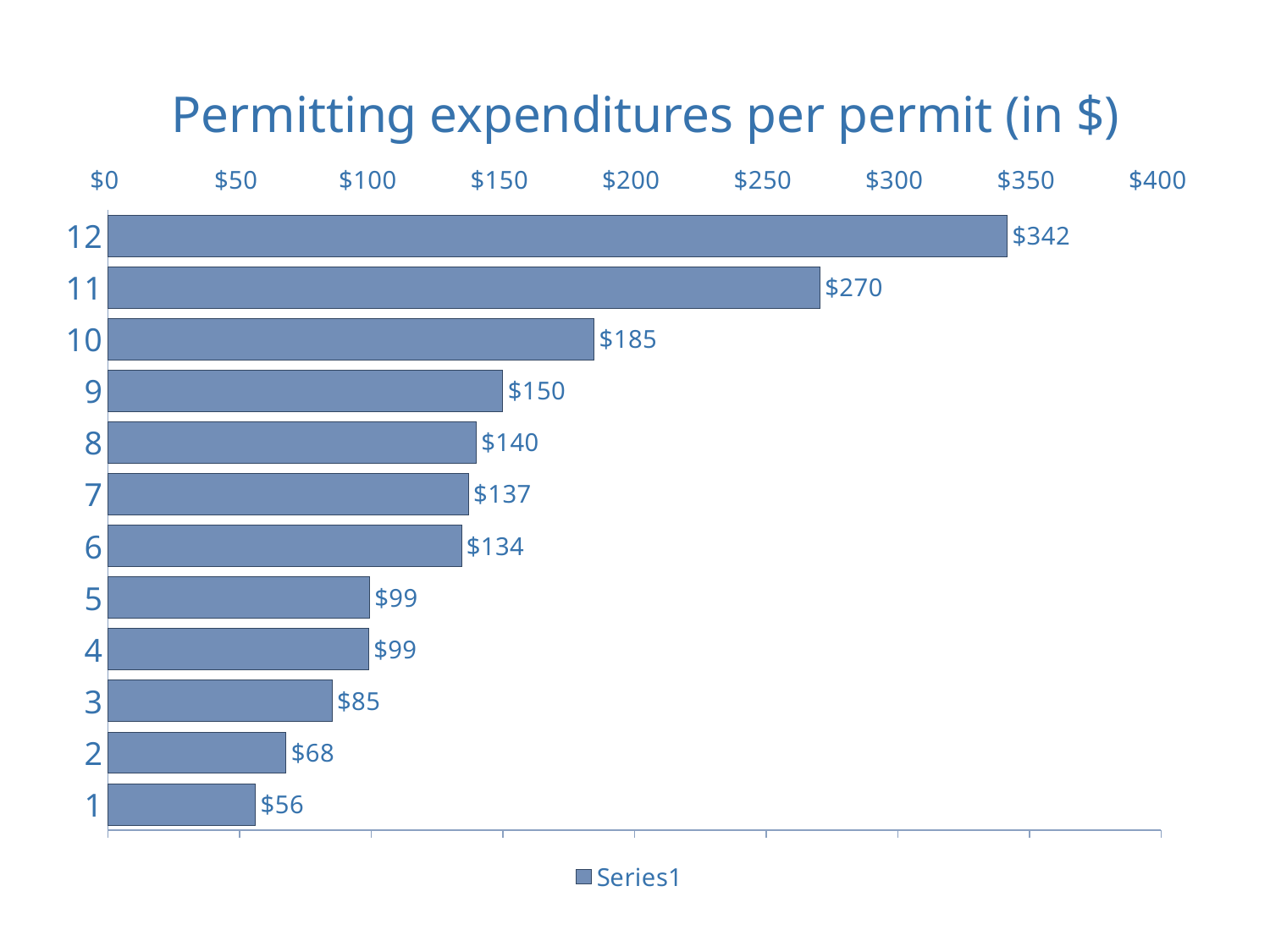
What is the value for category 7? $137 What is the title of the chart? Permitting expenditures per permit (in $) What is the value for category 1? $56 What kind of chart is shown on the slide? bar chart How many categories are shown in the chart? 12 Which category has the lowest value? 1 What is the difference between the values for category 10 and category 3? $100 Which is larger, the value for category 9 or the value for category 6? 9 Is the value for category 11 greater or less than $250? greater What is the difference between the values for category 12 and category 11? $72 Which category has the highest value? 12 What is the value for category 12? $342